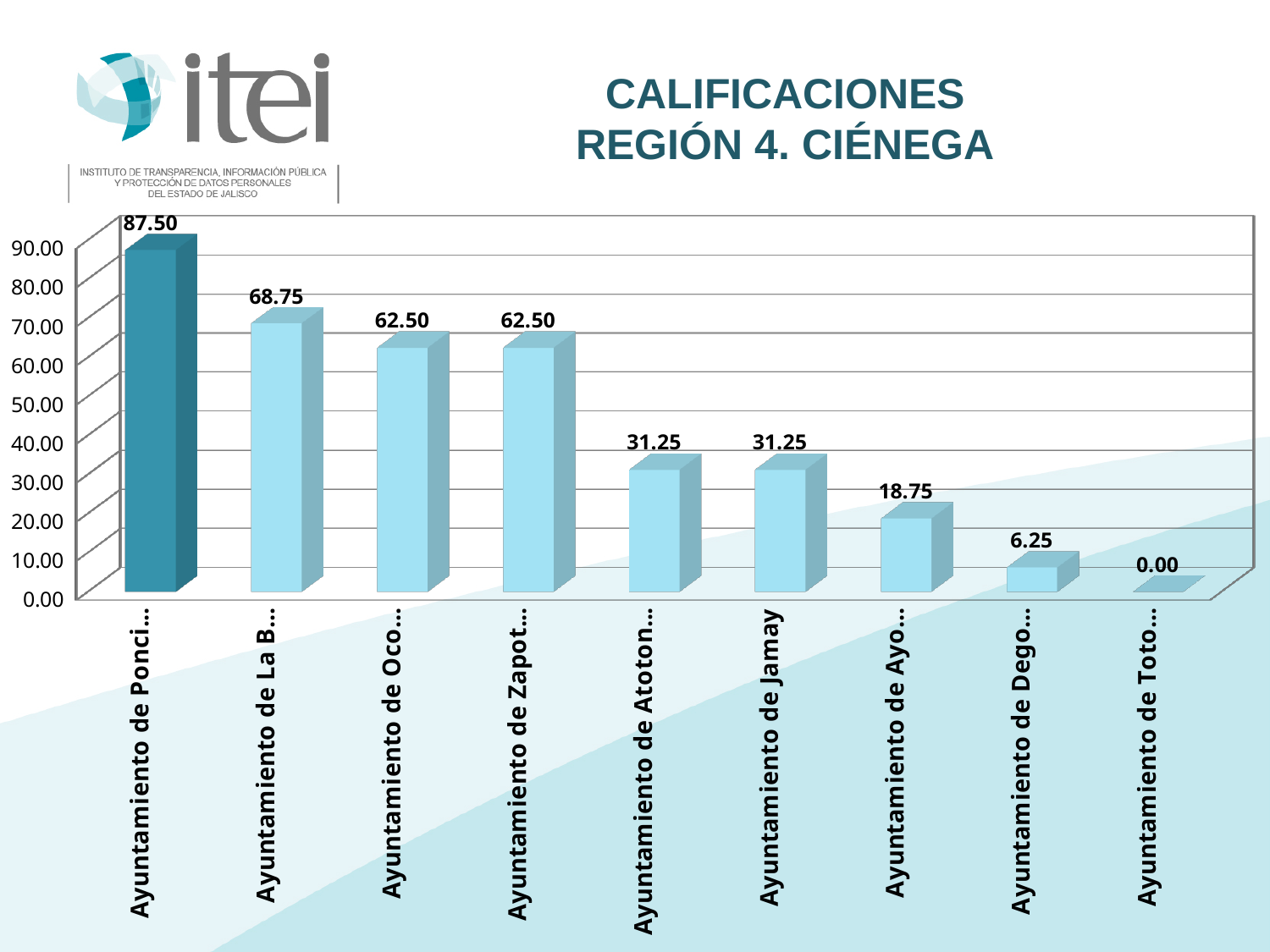
Do the values rise or fall from left to right along the x axis? Fall Which category has the lowest value in the chart? Ayuntamiento de Toto… What is the title shown on the slide above the chart? CALIFICACIONES REGIÓN 4. CIÉNEGA What value is shown for the bar labelled "Ayuntamiento de Ayo…"? 18.75 What value is shown for the first bar on the left, labelled "Ayuntamiento de Ponci…"? 87.50 What is the difference between the value for the bar labelled "Ayuntamiento de La B…" and the value for Ayuntamiento de Jamay? 37.50 What kind of chart is shown on the slide? Bar chart Which is larger: the value for the bar labelled "Ayuntamiento de Oco…" or the value for Ayuntamiento de Jamay? Ayuntamiento de Oco… What value is shown for the bar labelled "Ayuntamiento de Dego…"? 6.25 What value is shown for Ayuntamiento de Jamay? 31.25 Which category has the highest value in the chart? Ayuntamiento de Ponci… How many categories (bars) are shown in the chart? 9